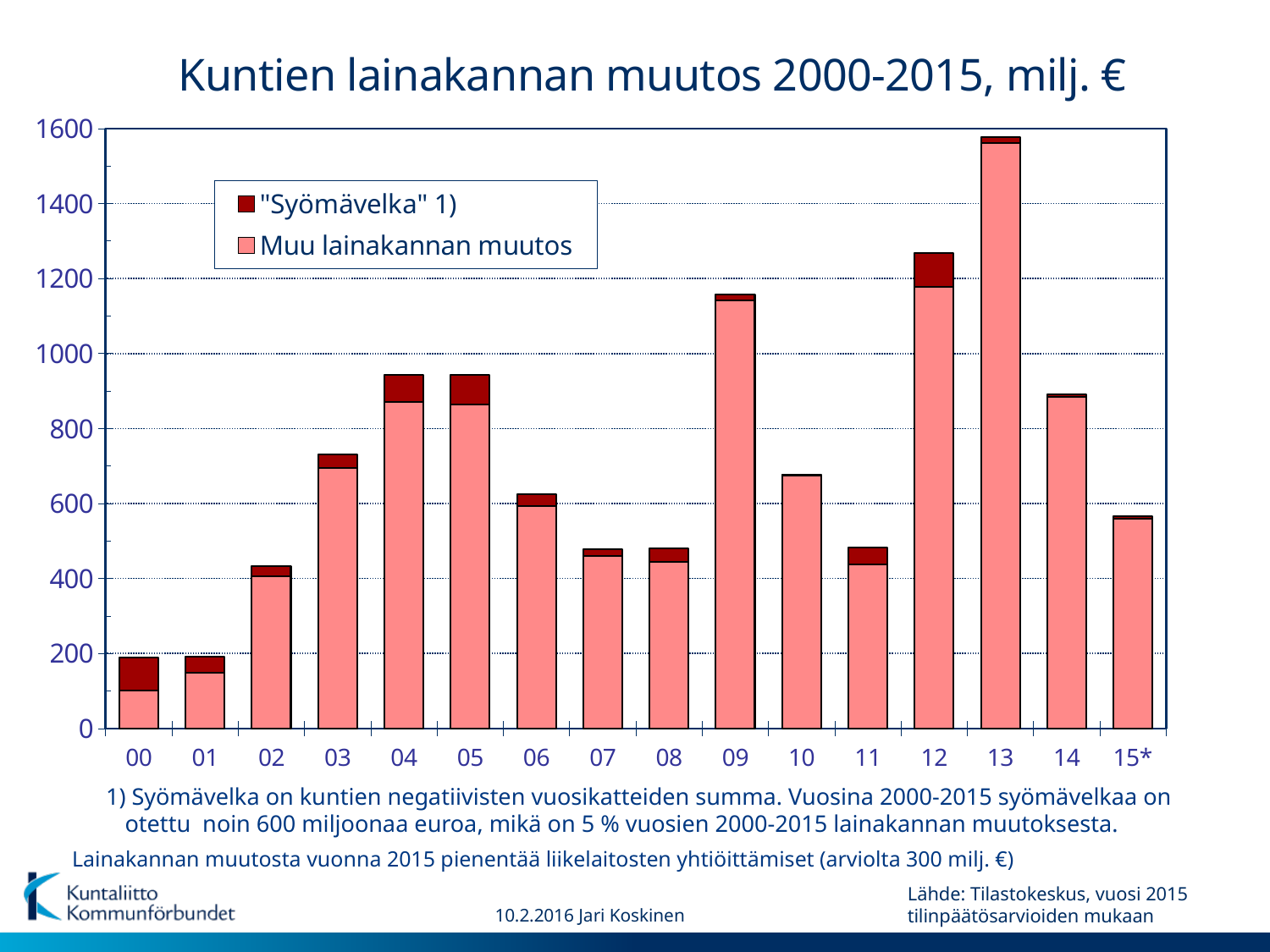
What kind of chart is shown on the slide? stacked bar chart How many series does the legend list? 2 What is the title of the chart? Kuntien lainakannan muutos 2000-2015, milj. € Which year has the highest total bar? 13 Do the total bar values rise or fall from 11 to 13? rise How many years (bars) are shown on the x axis? 16 Which has the larger total bar, 04 or 06? 04 Is the total value for 09 greater or less than 1000? greater Is the total value for 07 greater or less than 600? less Which has the larger total bar, 12 or 14? 12 Is the total value for 13 greater or less than 1400? greater